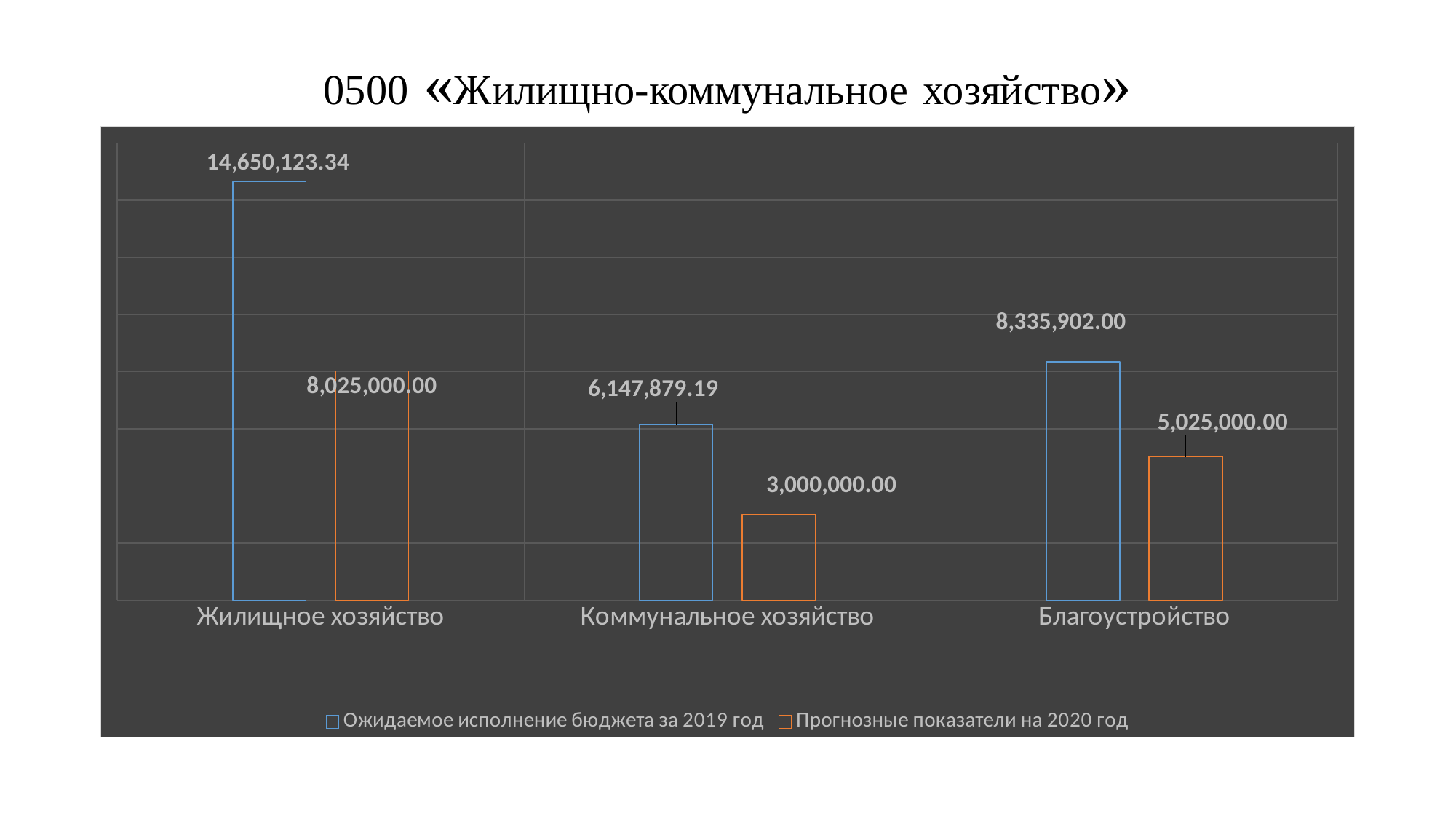
What is the value of "Прогнозные показатели на 2020 год" for Коммунальное хозяйство? 3,000,000.00 What type of chart is shown on the slide? bar chart What is the value of "Прогнозные показатели на 2020 год" for Благоустройство? 5,025,000.00 What is the value of "Ожидаемое исполнение бюджета за 2019 год" for Благоустройство? 8,335,902.00 What is the value of "Ожидаемое исполнение бюджета за 2019 год" for Жилищное хозяйство? 14,650,123.34 How many categories are shown on the x axis? 3 What is the difference between the 2019 and 2020 values for Жилищное хозяйство? 6,625,123.34 Which category has the highest value for "Ожидаемое исполнение бюджета за 2019 год"? Жилищное хозяйство What is the difference between the 2019 and 2020 values for Благоустройство? 3,310,902.00 Which category has the lowest value for "Прогнозные показатели на 2020 год"? Коммунальное хозяйство How many series does the legend list? 2 Which is larger: the 2019 value for Коммунальное хозяйство or the 2019 value for Благоустройство? Благоустройство